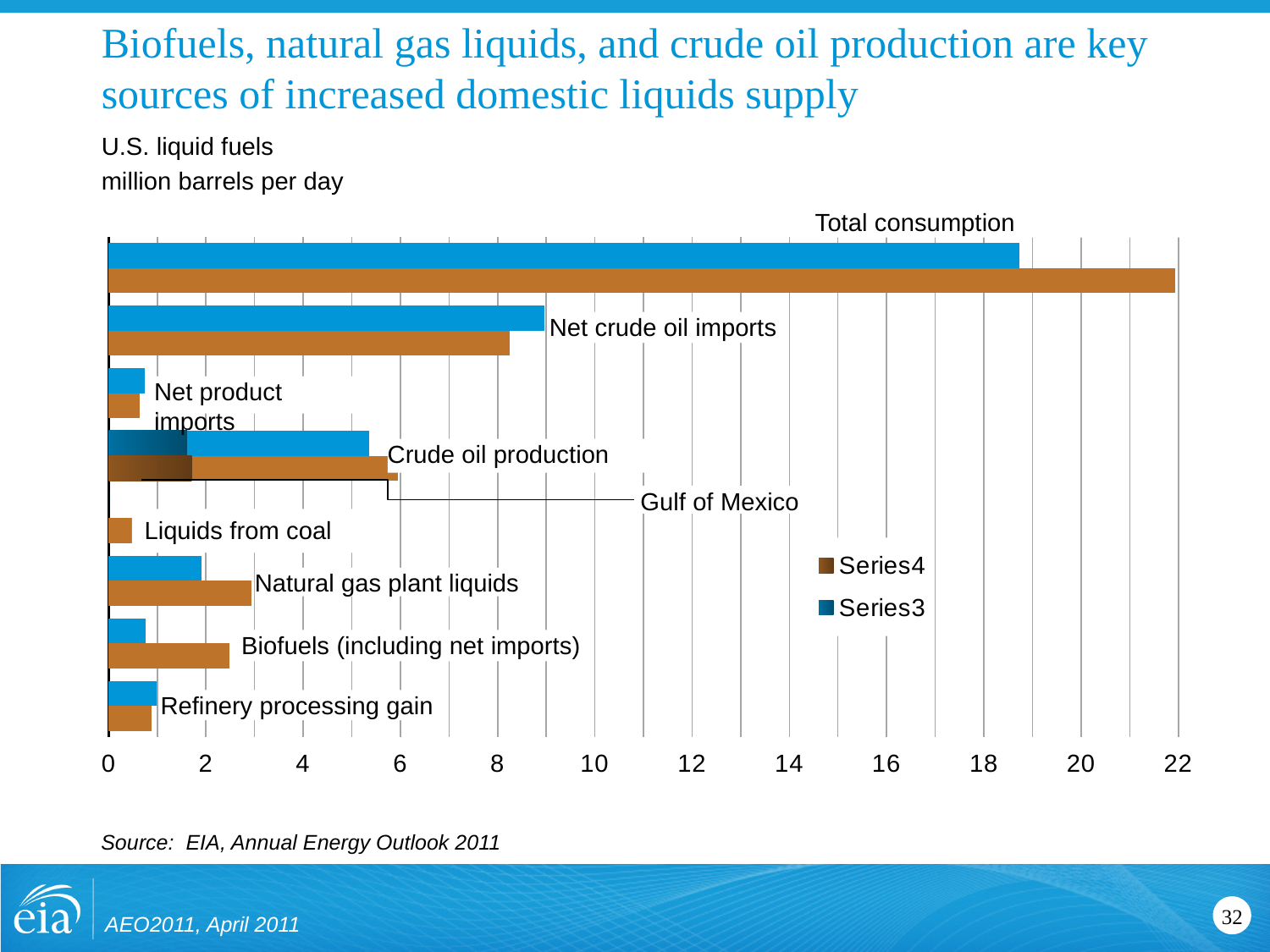
What unit is given for the values on the chart? million barrels per day Is the Series4 value for Biofuels (including net imports) greater or less than 2? greater Is the Series3 value for Crude oil production greater or less than 6? less Is the Series4 value for Total consumption greater or less than 20? greater For Natural gas plant liquids, which series has the larger value, Series3 or Series4? Series4 What kind of chart is shown on the slide? bar chart How many series does the legend list? 2 Which category has the highest value for Series3? Total consumption For Total consumption, which series has the larger value, Series3 or Series4? Series4 How many categories are plotted on the chart? 8 Which category has the highest value for Series4? Total consumption For Net crude oil imports, which series has the larger value, Series3 or Series4? Series3